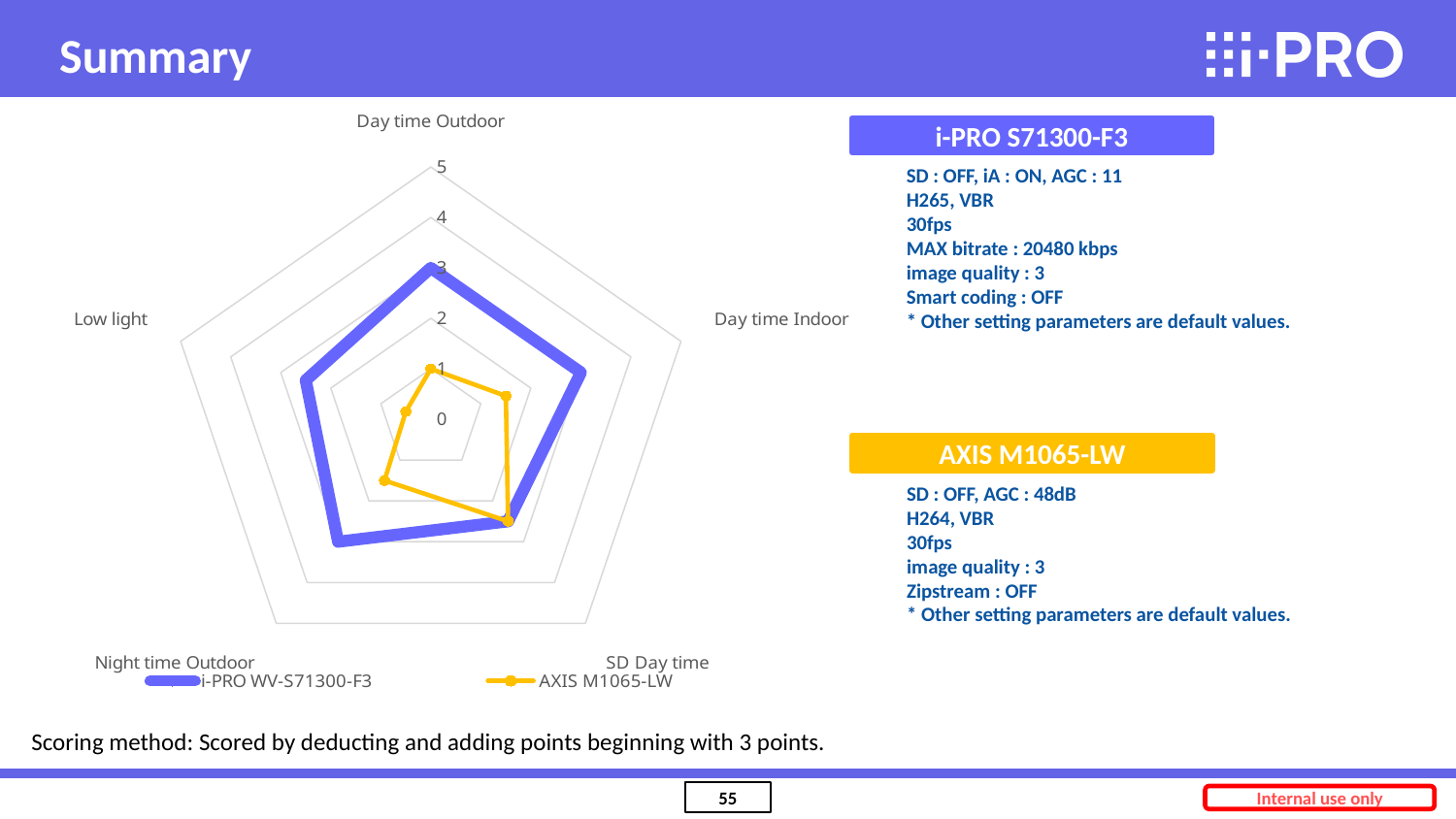
What is the maximum value shown on the radar chart's scale? 5 How many series does the chart legend list? 2 Which series scores higher on the Low light axis, i-PRO WV-S71300-F3 or AXIS M1065-LW? i-PRO WV-S71300-F3 What kind of chart is shown on the slide? radar chart Is the score for AXIS M1065-LW on the Day time Indoor axis greater or less than 3? less Which series scores higher on the Night time Outdoor axis? i-PRO WV-S71300-F3 Is the score for AXIS M1065-LW on the Low light axis greater or less than 2? less What is the score for i-PRO WV-S71300-F3 on the Day time Outdoor axis? 3 What is the score for AXIS M1065-LW on the Day time Outdoor axis? 1 Which series is drawn in yellow on the radar chart? AXIS M1065-LW How many categories (axes) does the radar chart have? 5